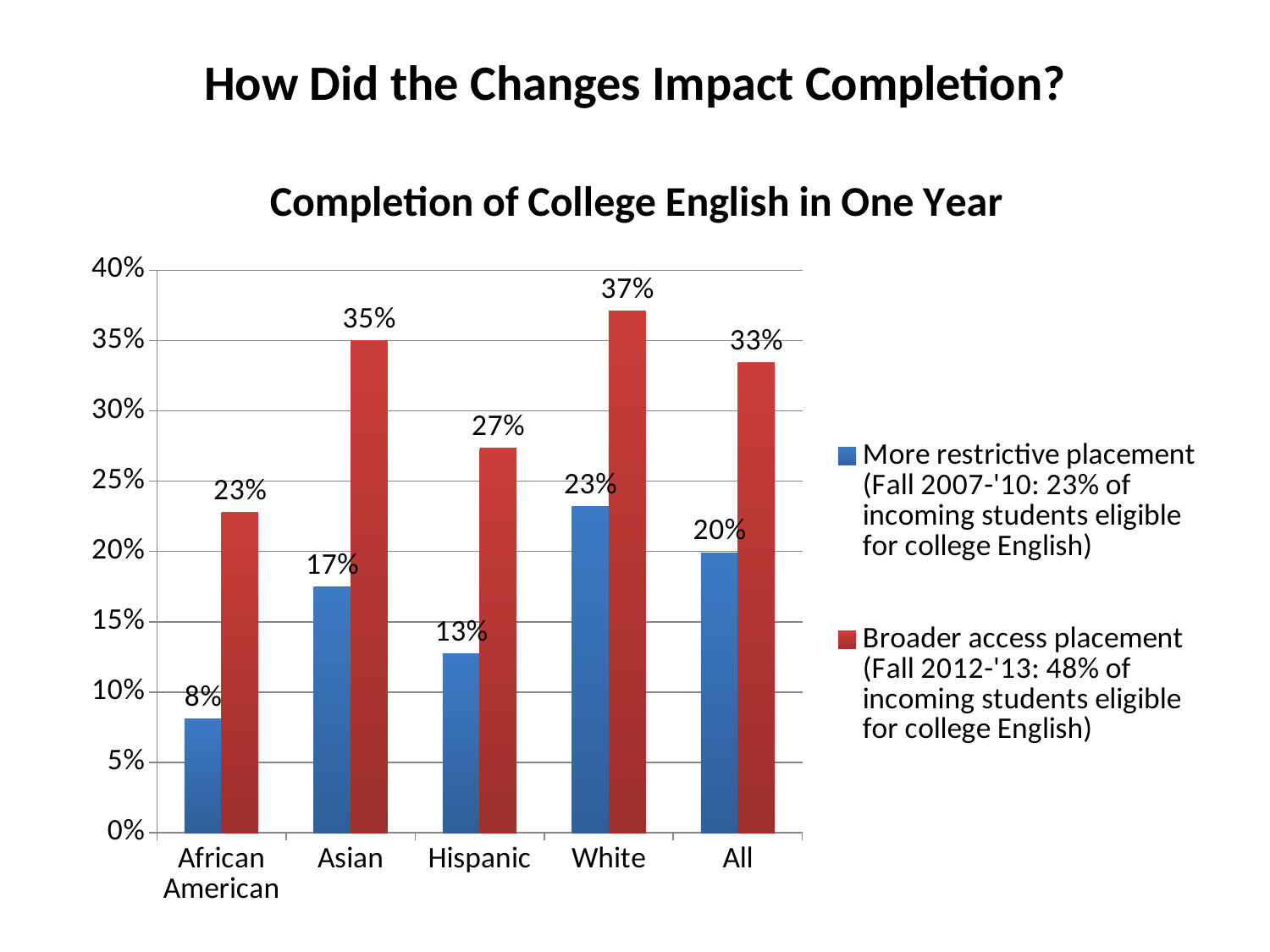
How many series does the legend list? 2 What is the completion rate for Asian students under the broader access placement? 35% Which category has the lowest completion rate under the more restrictive placement? African American Is the broader access completion rate for White students greater or less than 35%? greater What is the completion rate for All students under the more restrictive placement? 20% How many categories are shown on the x axis? 5 What is the difference between the broader access and more restrictive completion rates for African American students? 15% What is the completion rate for Hispanic students under the broader access placement? 27% What is the completion rate for African American students under the more restrictive placement? 8% Which category has the highest completion rate under the broader access placement? White Which is larger: the broader access completion rate for Hispanic students or the more restrictive completion rate for White students? Broader access for Hispanic students What kind of chart is shown on the slide? Bar chart